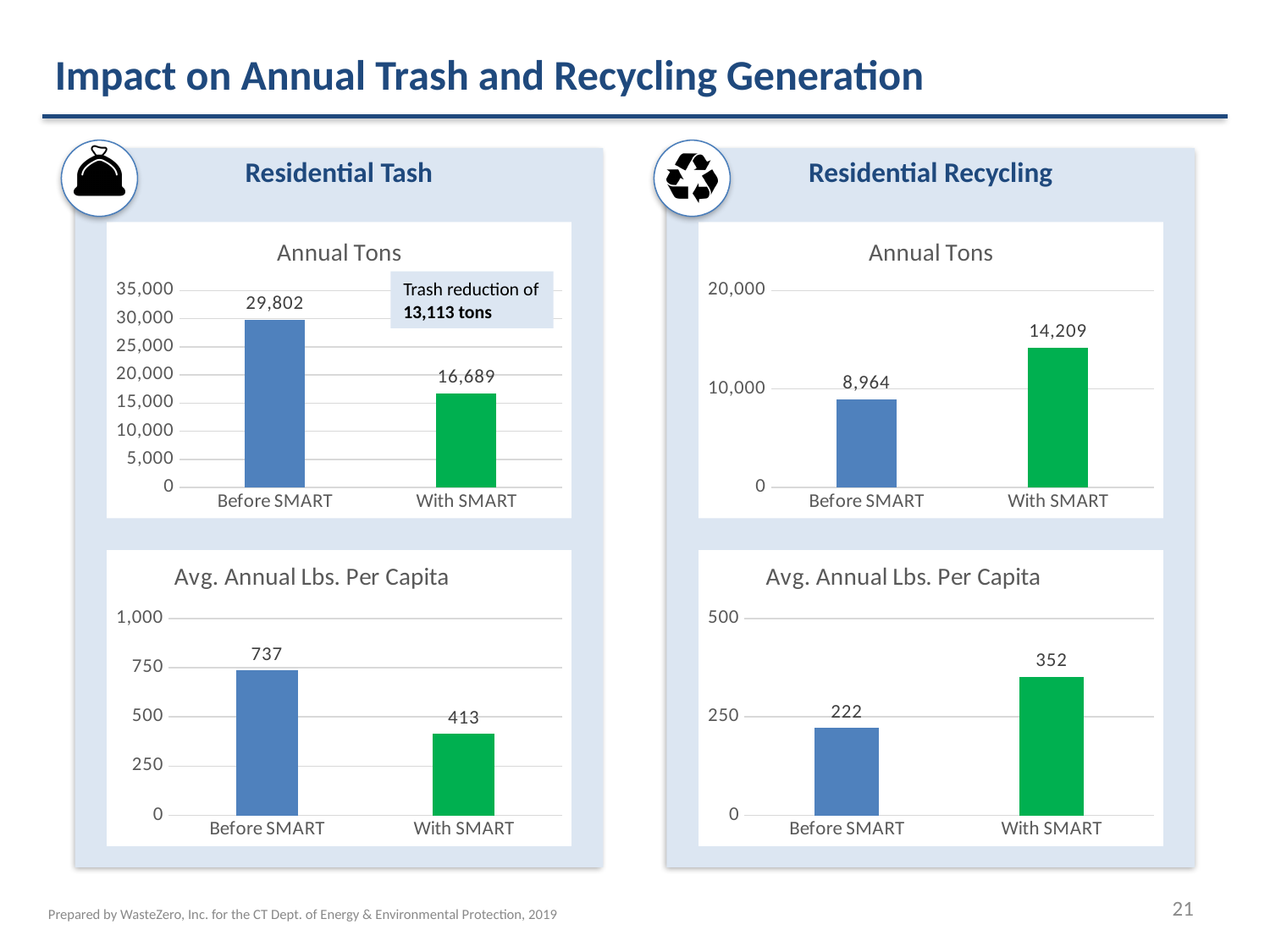
In the Residential Trash Avg. Annual Lbs. Per Capita chart, which category is highest? Before SMART What kind of chart is the Residential Recycling Annual Tons chart? bar chart In the Residential Trash Annual Tons chart, what is the difference between Before SMART and With SMART? 13,113 In the Residential Trash Annual Tons chart, what is the value for Before SMART? 29,802 In the Residential Recycling Avg. Annual Lbs. Per Capita chart, is the value for With SMART larger or smaller than the value for Before SMART? larger How many categories does the Residential Trash Annual Tons chart show? 2 In the Residential Recycling Annual Tons chart, which category is lowest? Before SMART In the Residential Trash Annual Tons chart, what is the value for With SMART? 16,689 In the Residential Recycling Annual Tons chart, what is the difference between With SMART and Before SMART? 5,245 In the Residential Trash Avg. Annual Lbs. Per Capita chart, what is the value for With SMART? 413 In the Residential Recycling Avg. Annual Lbs. Per Capita chart, what is the value for Before SMART? 222 In the Residential Recycling Annual Tons chart, what is the value for With SMART? 14,209